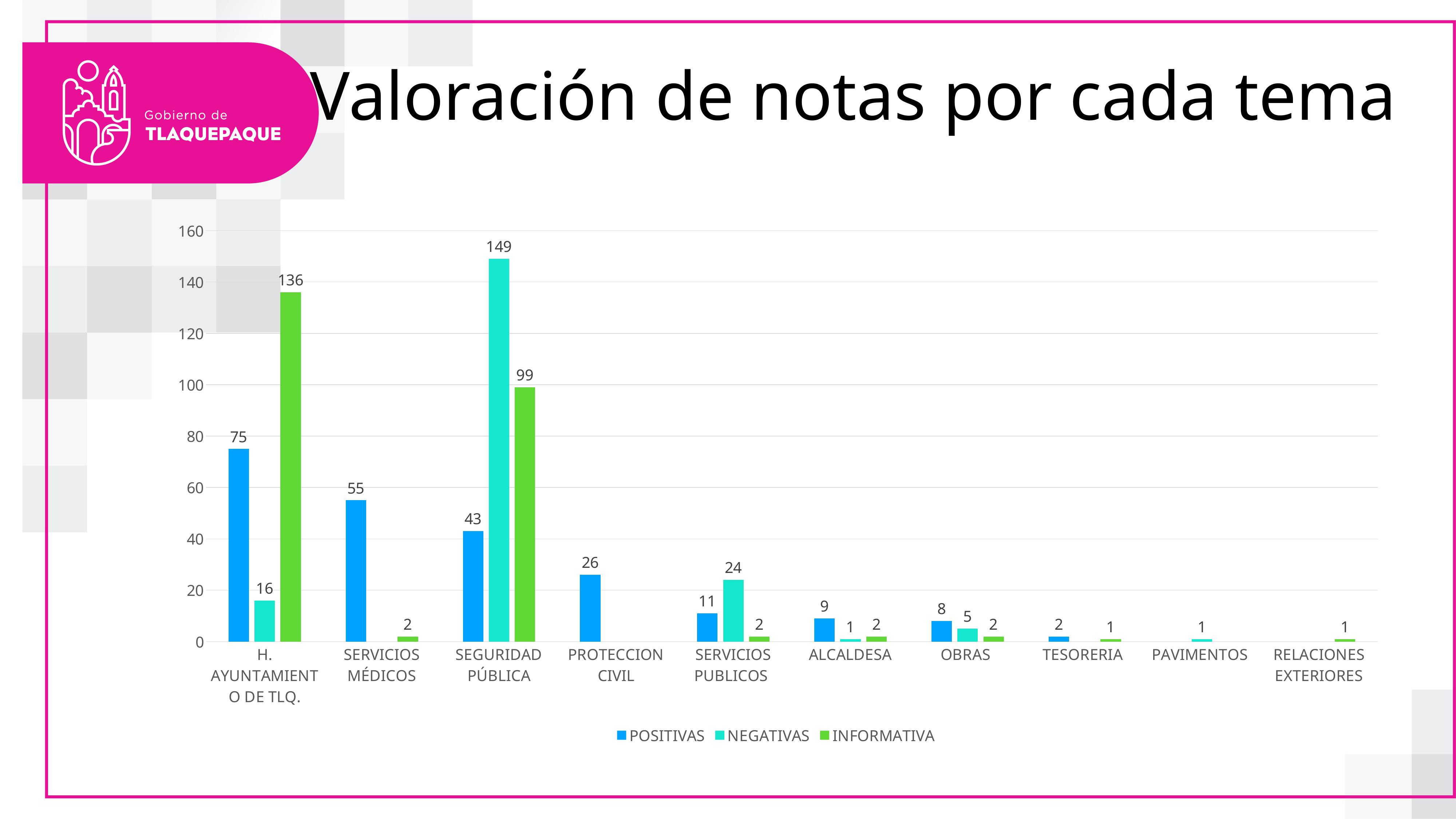
What is the POSITIVAS value for PROTECCION CIVIL? 26 What is the INFORMATIVA value for H. AYUNTAMIENTO DE TLQ.? 136 How many categories are shown on the x axis? 10 Which category has the highest POSITIVAS value? H. AYUNTAMIENTO DE TLQ. How many series does the legend list? 3 What is the difference between the NEGATIVAS and INFORMATIVA values for SEGURIDAD PÚBLICA? 50 Which is larger for SERVICIOS PUBLICOS, POSITIVAS or NEGATIVAS? NEGATIVAS What kind of chart is shown on the slide? Bar chart What is the title of the slide? Valoración de notas por cada tema What is the NEGATIVAS value for SEGURIDAD PÚBLICA? 149 Which category has the highest NEGATIVAS value? SEGURIDAD PÚBLICA What is the POSITIVAS value for SERVICIOS MÉDICOS? 55